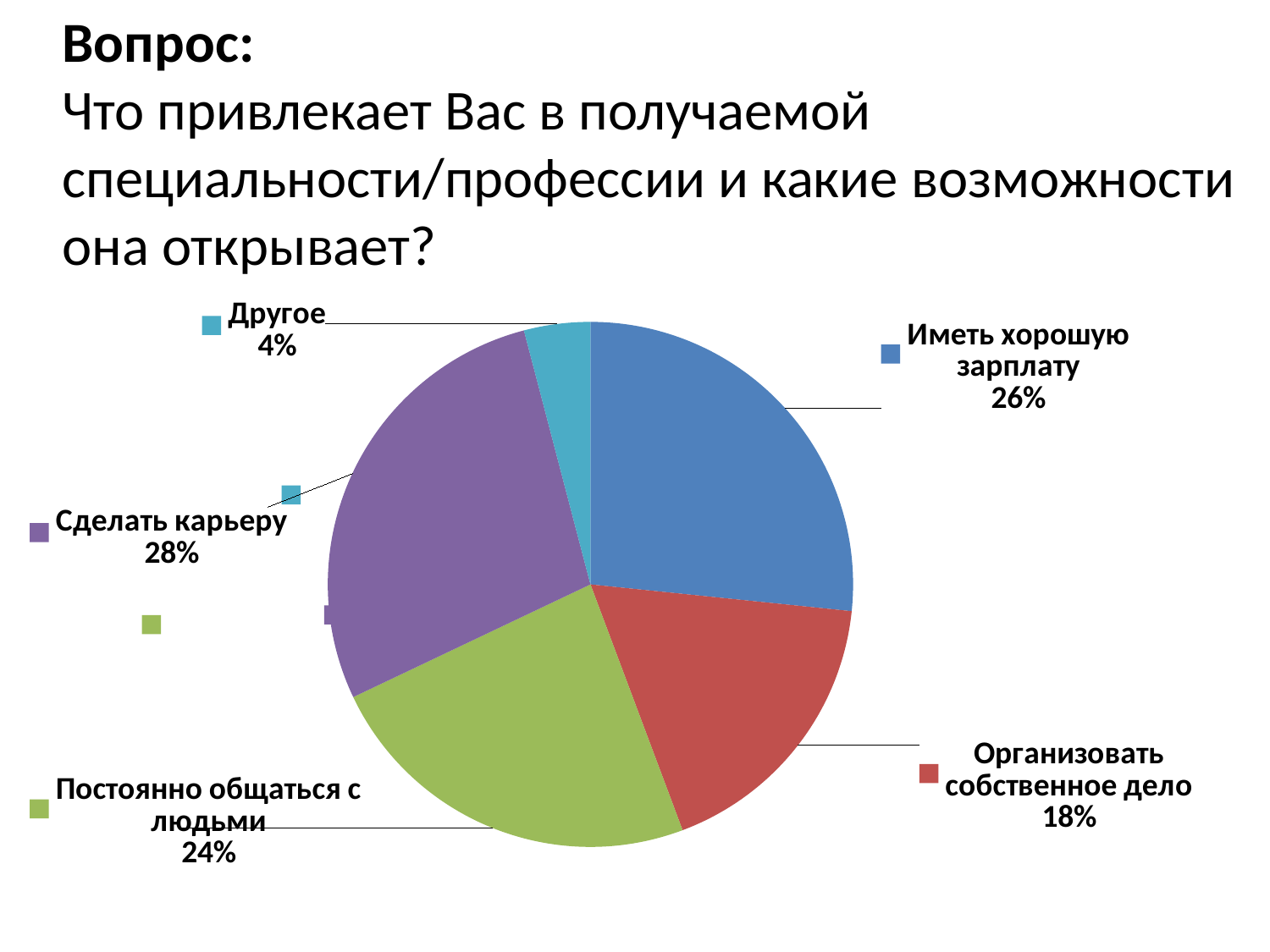
How many slices does the pie chart have? 5 Which category has the largest slice of the pie? Сделать карьеру What share of the pie is labelled "Постоянно общаться с людьми"? 24% What is the difference in percentage points between "Сделать карьеру" and "Организовать собственное дело"? 10 What kind of chart is shown on the slide? pie chart What colour is the slice for "Организовать собственное дело"? red Which category has the smallest slice of the pie? Другое What share of the pie is labelled "Организовать собственное дело"? 18% What share of the pie is labelled "Сделать карьеру"? 28% Which is larger: the share for "Иметь хорошую зарплату" or the share for "Постоянно общаться с людьми"? Иметь хорошую зарплату What share of the pie is labelled "Иметь хорошую зарплату"? 26% What share of the pie is labelled "Другое"? 4%